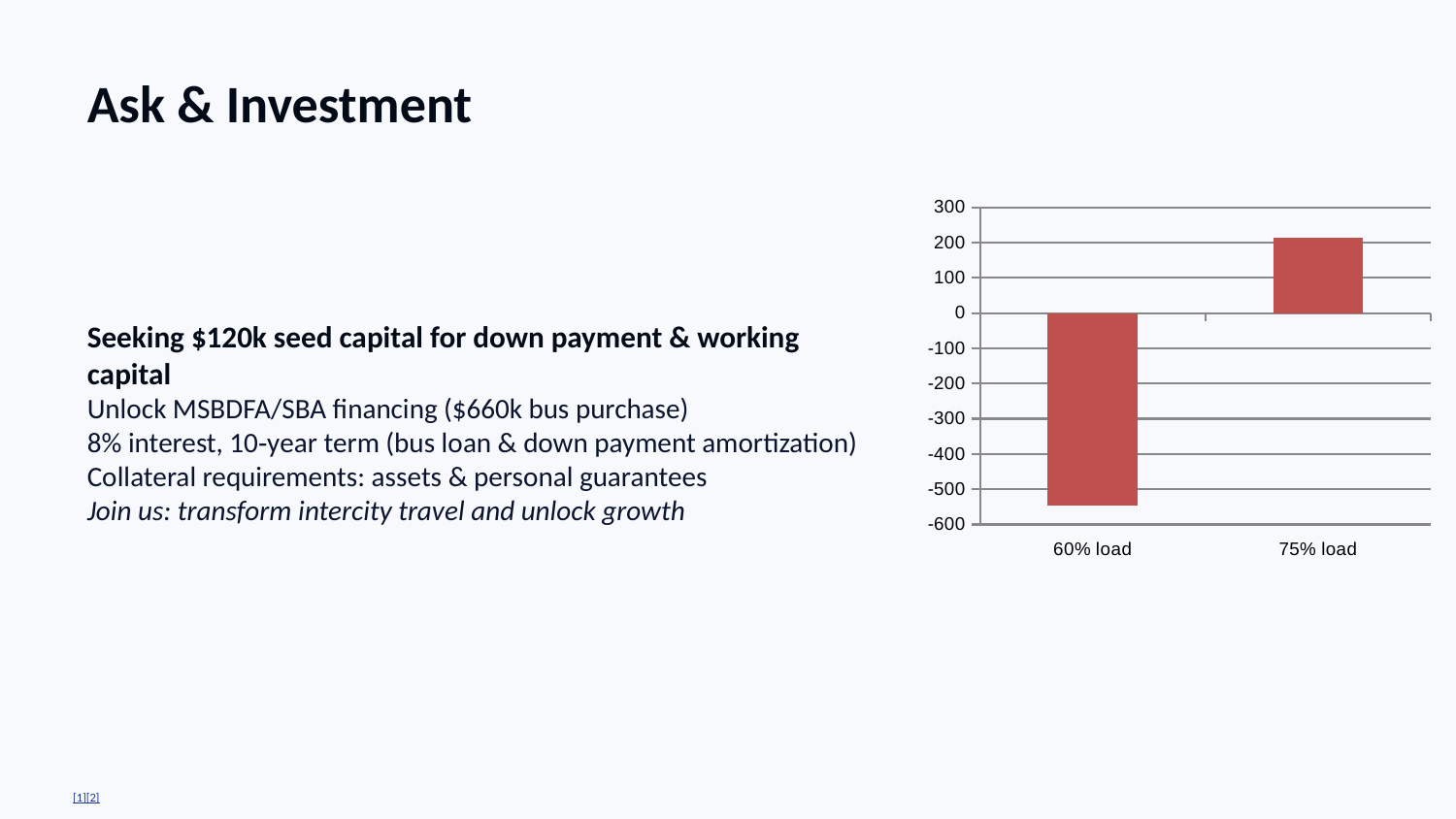
Is the value for 60% load greater or less than 0? less Is the value for 60% load greater or less than -500? less Is the value for 75% load greater or less than 100? greater What kind of chart is shown on the slide? bar chart What is the lowest value shown on the chart's vertical axis? -600 What colour are the bars in the chart? red How many categories are shown on the x axis of the chart? 2 Which category has the highest value in the chart? 75% load Which category has the lowest value in the chart? 60% load Do the values rise or fall from 60% load to 75% load? rise Which is larger, the value for 60% load or the value for 75% load? 75% load